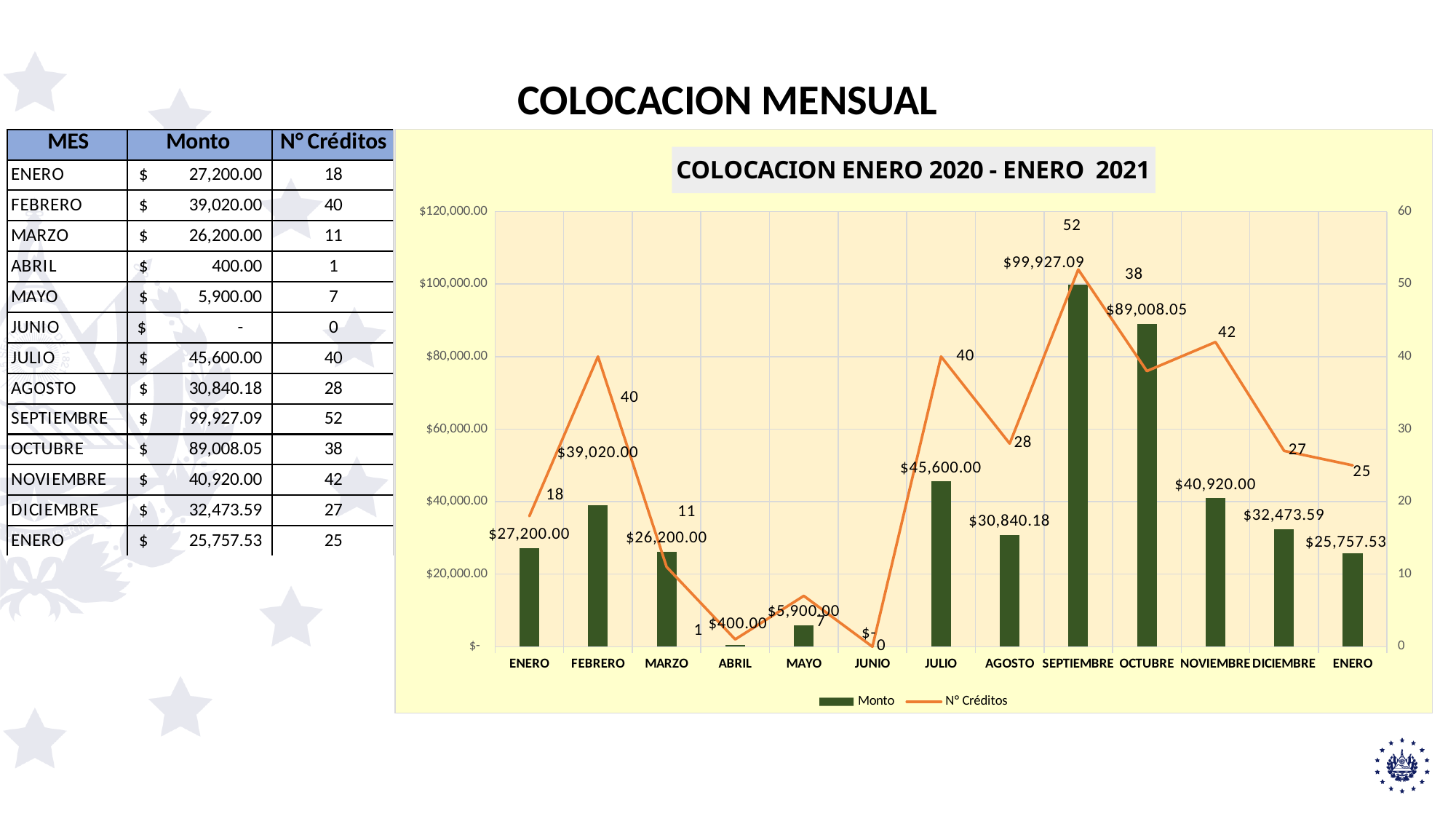
Which has a larger Monto, JULIO or AGOSTO? JULIO Which month has the lowest N° Créditos in the chart? JUNIO What kind of chart is shown on the slide? Combination bar and line chart What is the Monto value for the last ENERO (rightmost category) in the chart? $25,757.53 What is the Monto value for SEPTIEMBRE in the chart? $99,927.09 Which month has the highest Monto in the chart? SEPTIEMBRE What is the title of the chart? COLOCACION ENERO 2020 - ENERO 2021 How many series does the chart legend list? 2 How many N° Créditos does the chart show for NOVIEMBRE? 42 What is the difference in N° Créditos between NOVIEMBRE and DICIEMBRE? 15 What is the difference in Monto between SEPTIEMBRE and OCTUBRE? $10,919.04 How many months (categories) are shown on the x axis of the chart? 13